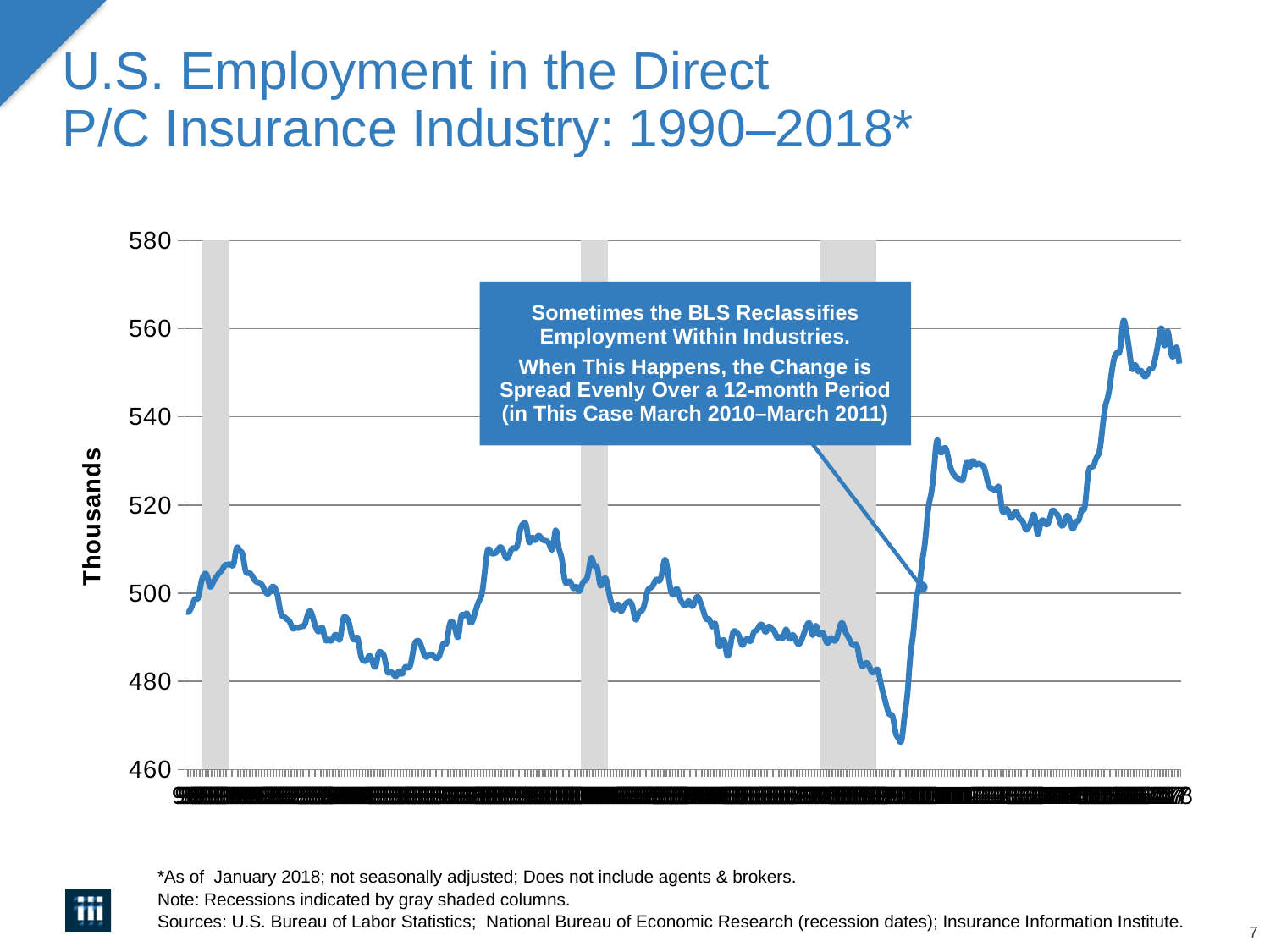
Is the value at the end of the series (January 2018) larger or smaller than the value at the start of the series (1990)? larger What is the title of the chart on the slide? U.S. Employment in the Direct P/C Insurance Industry: 1990–2018* Is the lowest point of the line greater or less than 480? less What kind of chart is shown on the slide? Line chart What is the highest value shown on the vertical axis? 580 What is the label on the vertical axis of the chart? Thousands Is the value at the start of the series (1990) greater or less than 480? greater Is the highest point of the line greater or less than 540? greater Overall, does employment rise or fall from the start of the series in 1990 to the end in 2018? rise How many data series (lines) are plotted on the chart? 1 How many gray shaded recession columns appear on the chart? 3